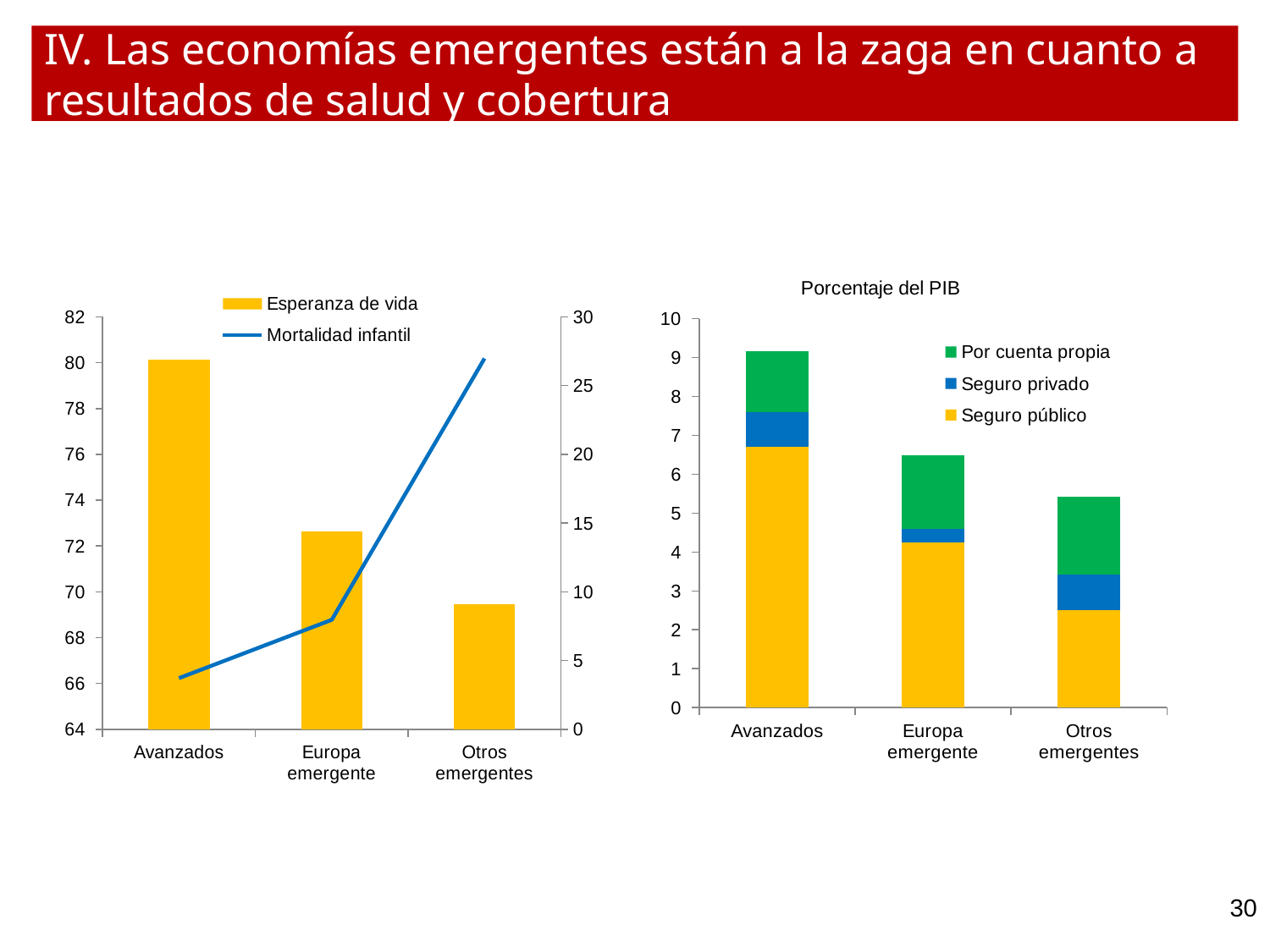
What kind of chart is the right chart titled 'Porcentaje del PIB'? A stacked bar chart What kind of chart is the left chart? A combined bar and line chart In the left chart, which category has the lowest Esperanza de vida? Otros emergentes In the right chart 'Porcentaje del PIB', is the Seguro público value for Avanzados greater or less than 6? greater In the left chart, does the Mortalidad infantil line rise or fall from Avanzados to Otros emergentes? It rises In the left chart, is the Esperanza de vida for Avanzados greater or less than 78? greater How many series does the legend of the left chart list? 2 In the right chart 'Porcentaje del PIB', which category has the tallest stacked bar? Avanzados How many series does the legend of the right chart 'Porcentaje del PIB' list? 3 In the left chart, is the Mortalidad infantil value for Otros emergentes greater or less than 25? greater In the left chart, which category has the highest Esperanza de vida? Avanzados